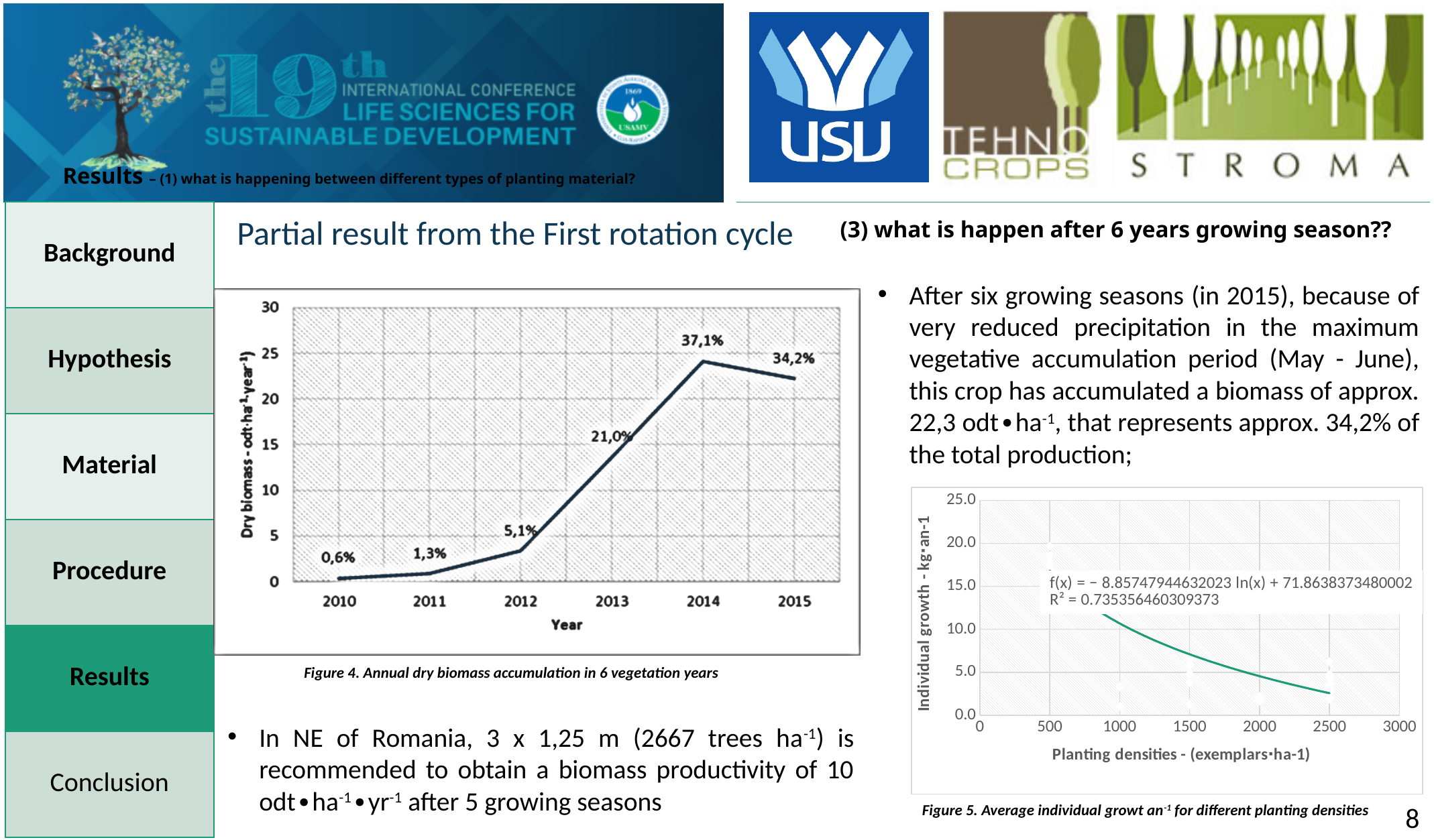
In Figure 4 (Annual dry biomass accumulation), which year has the lowest dry biomass value? 2010 In Figure 4 (Annual dry biomass accumulation), is the dry biomass value for 2012 greater or less than 5? less In Figure 4 (Annual dry biomass accumulation), what kind of chart is shown? line chart In Figure 4 (Annual dry biomass accumulation), which year has the highest percentage label? 2014 In Figure 5 (Average individual growth for different planting densities), does the trendline rise or fall as planting density increases? fall In Figure 4 (Annual dry biomass accumulation), is the dry biomass value for 2014 greater or less than 20? greater In Figure 4 (Annual dry biomass accumulation), what percentage label is shown for 2010? 0,6% In Figure 5 (Average individual growth for different planting densities), what is the R² value printed on the chart? 0.735356460309373 In Figure 4 (Annual dry biomass accumulation), what percentage label is shown for 2013? 21,0% In Figure 4 (Annual dry biomass accumulation), what percentage label is shown for 2014? 37,1% In Figure 4 (Annual dry biomass accumulation), how many years are plotted on the x axis? 6 In Figure 4 (Annual dry biomass accumulation), what is the difference between the percentage labels for 2014 and 2015? 2,9%